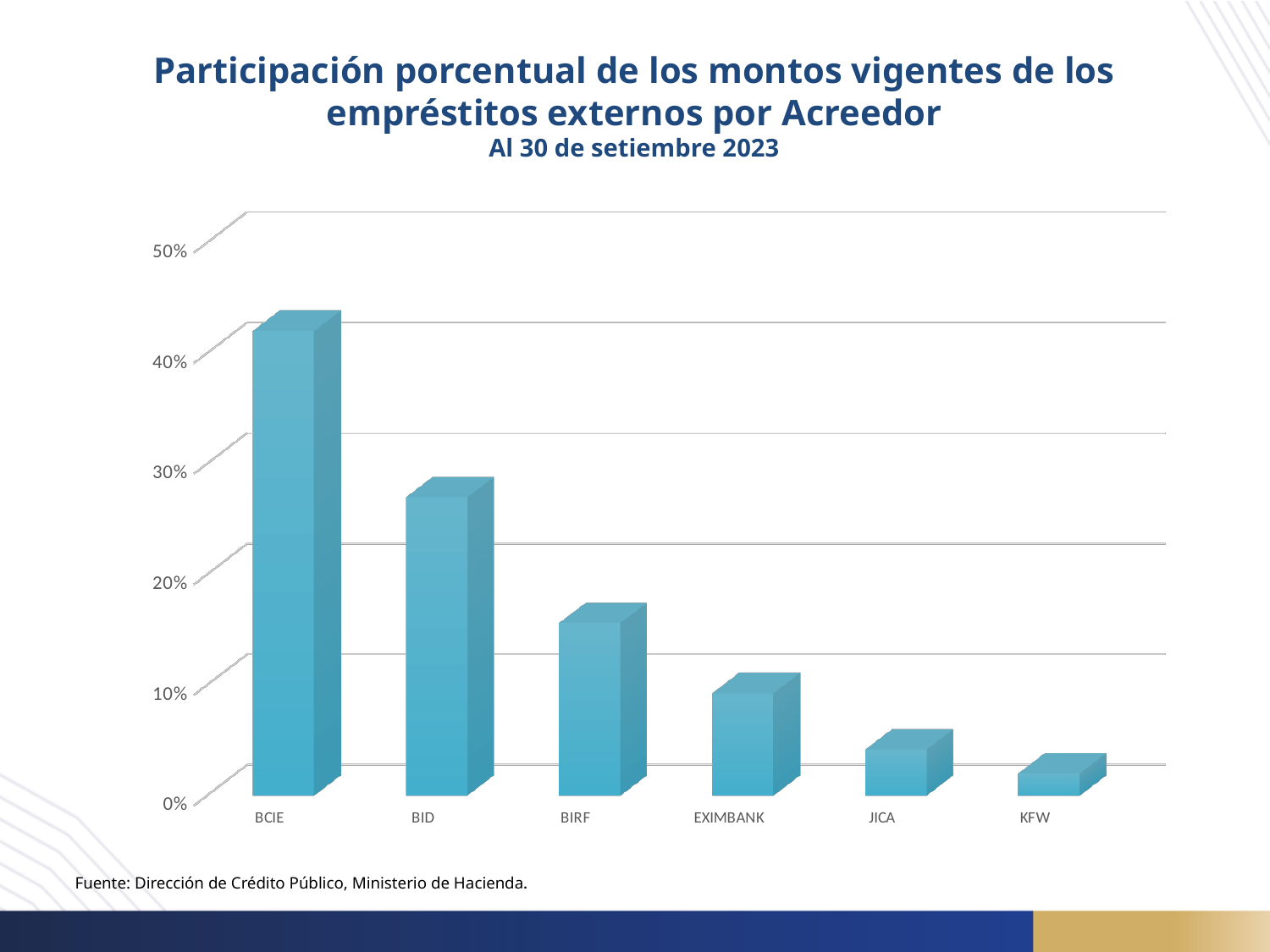
Which creditor has the highest share? BCIE Which creditor has the lowest share? KFW As of what date is the data in the chart reported? Al 30 de setiembre 2023 What kind of chart is shown on the slide? bar chart Which has a larger share, EXIMBANK or JICA? EXIMBANK Do the values rise or fall moving from left to right along the x axis? fall How many creditors (categories) are shown on the x axis? 6 Is the value for BIRF greater or less than 20%? less Which has a larger share, BID or BIRF? BID Is the value for BCIE greater or less than 30%? greater Is the value for JICA greater or less than 10%? less